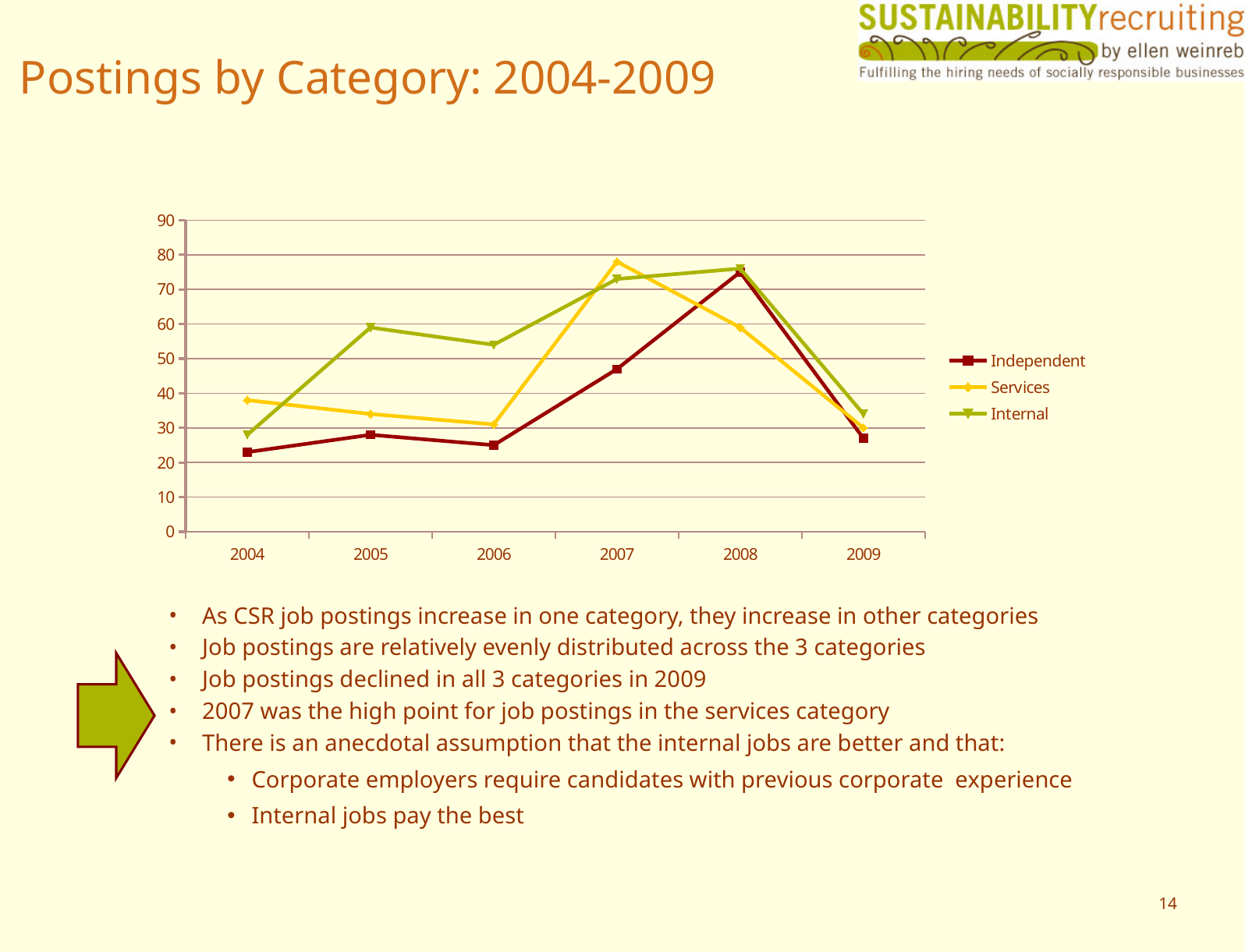
In 2005, which series has the larger value, Internal or Services? Internal What kind of chart is shown on the slide? line chart What is the title of the chart slide? Postings by Category: 2004-2009 Is the value for Independent in 2004 greater or less than 30? less In which year does the Services series reach its highest value? 2007 Is the value for Independent in 2008 greater or less than 70? greater How many years are plotted along the x axis? 6 In which year does the Independent series reach its highest value? 2008 Is the value for Internal in 2005 greater or less than 50? greater In which year is the Internal series at its lowest value? 2004 Does the Independent series rise or fall from 2006 to 2008? rise How many series does the legend list? 3